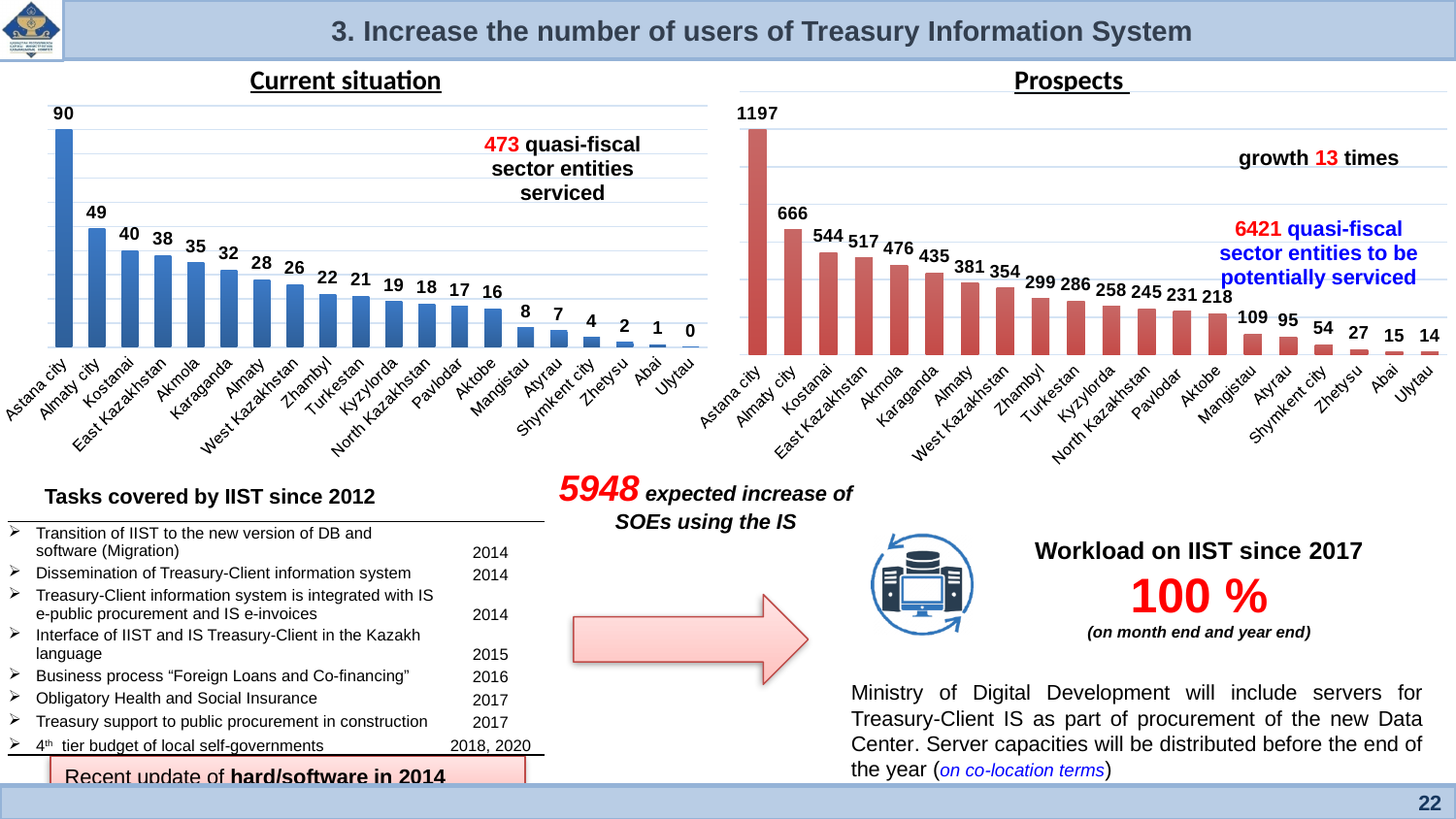
In the Prospects chart, which category has the highest value? Astana city In the Current situation chart, what is the value for Karaganda? 32 In the Prospects chart, what is the value for Kostanai? 544 In the Prospects chart, what is the value for Mangistau? 109 In the Current situation chart, what is the difference between the values for Almaty city and Kostanai? 9 What type of chart is the Prospects chart? Bar chart In the Prospects chart, what is the difference between the values for Astana city and Almaty city? 531 In the Current situation chart, which category has the lowest value? Ulytau How many categories are shown in the Current situation chart? 20 Do the values in the Current situation chart rise or fall from left to right along the x axis? Fall In the Current situation chart, what is the value for Astana city? 90 In the Prospects chart, which is larger, the value for Akmola or the value for Pavlodar? Akmola